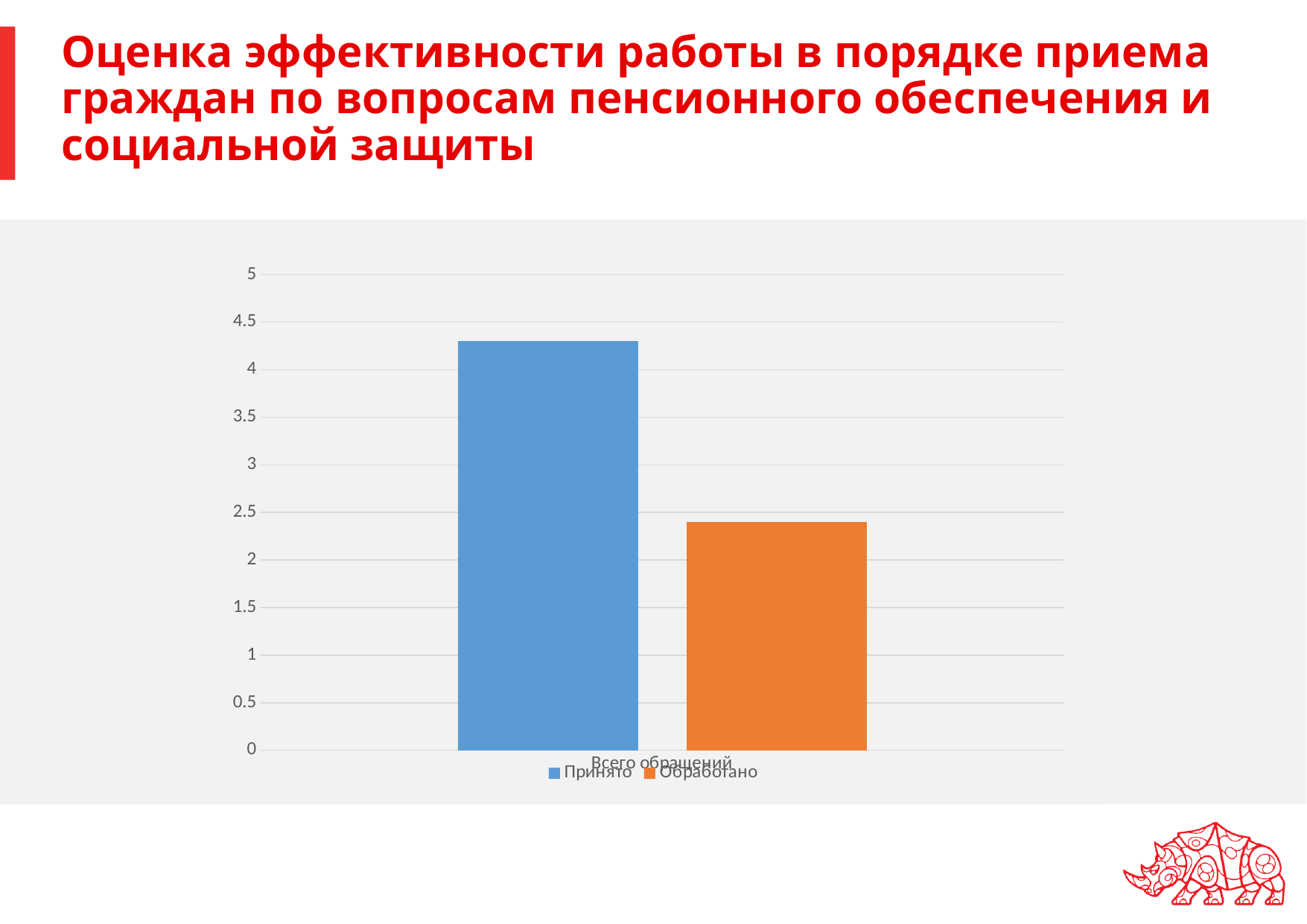
Which series has the higher value for Всего обращений? Принято What kind of chart is shown on the slide? bar chart What colour is the bar for the Принято series? blue What is the label of the category on the x axis? Всего обращений How many series does the legend list? 2 How many categories are shown on the x axis? 1 Which series has the lower value for Всего обращений? Обработано Is the value for Принято greater or less than 4.5? less Is the value for Принято greater or less than 4? greater Is the value for Обработано greater or less than 3? less Is the value for Принято larger or smaller than the value for Обработано? larger